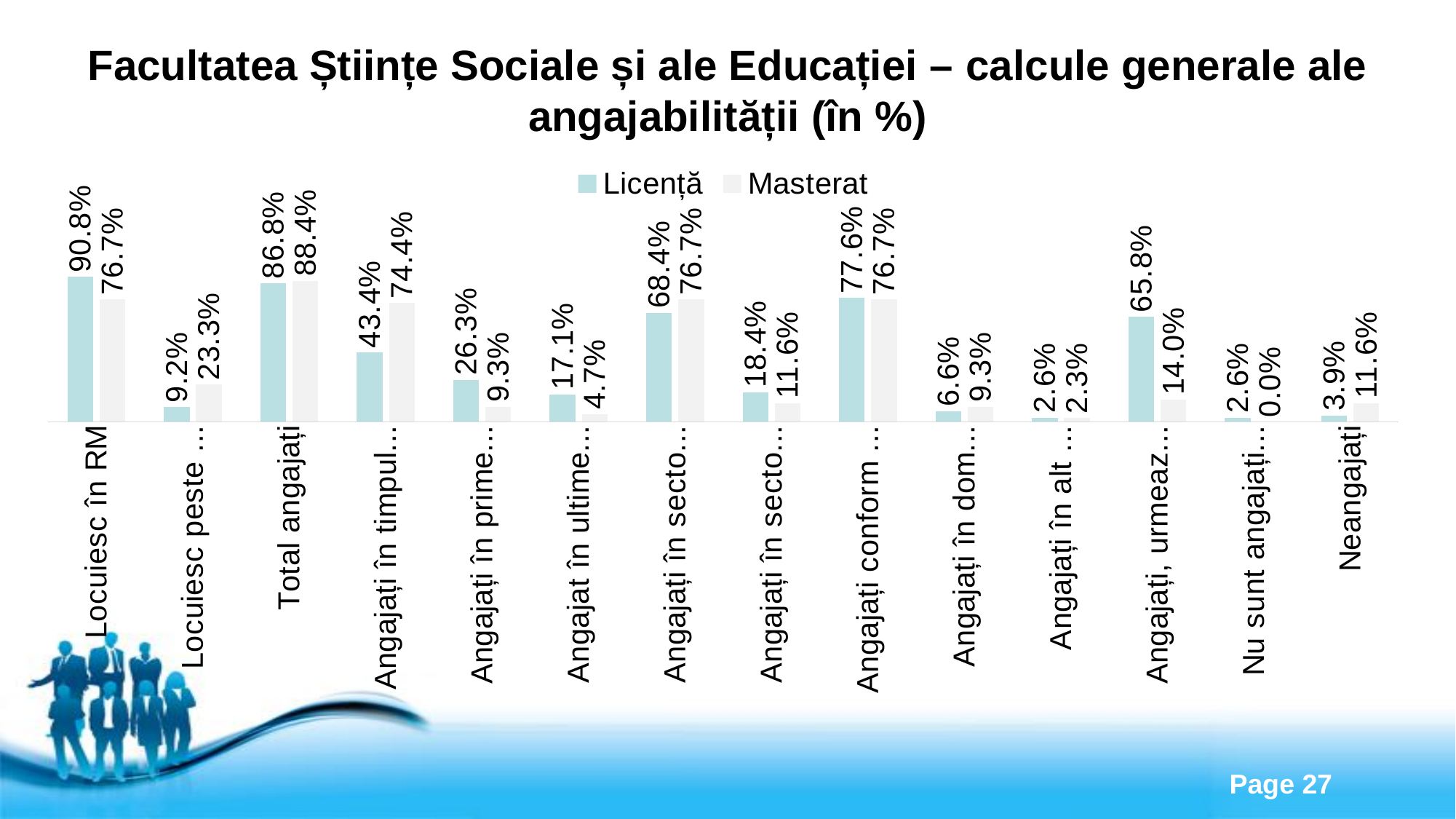
What is the Masterat value for "Neangajați"? 11.6% What is the Licență value for "Neangajați"? 3.9% What is the Masterat value for "Total angajați"? 88.4% How many categories are shown on the x axis? 14 Which category has the highest Masterat value? Total angajați How many series does the legend list? 2 For "Neangajați", which series has the larger value, Licență or Masterat? Masterat For "Locuiesc în RM", how much higher is the Licență value than the Masterat value? 14.1 percentage points What kind of chart is shown on the slide? Bar chart Which category has the highest Licență value? Locuiesc în RM For "Total angajați", which series has the larger value, Licență or Masterat? Masterat What is the Licență value for "Locuiesc în RM"? 90.8%